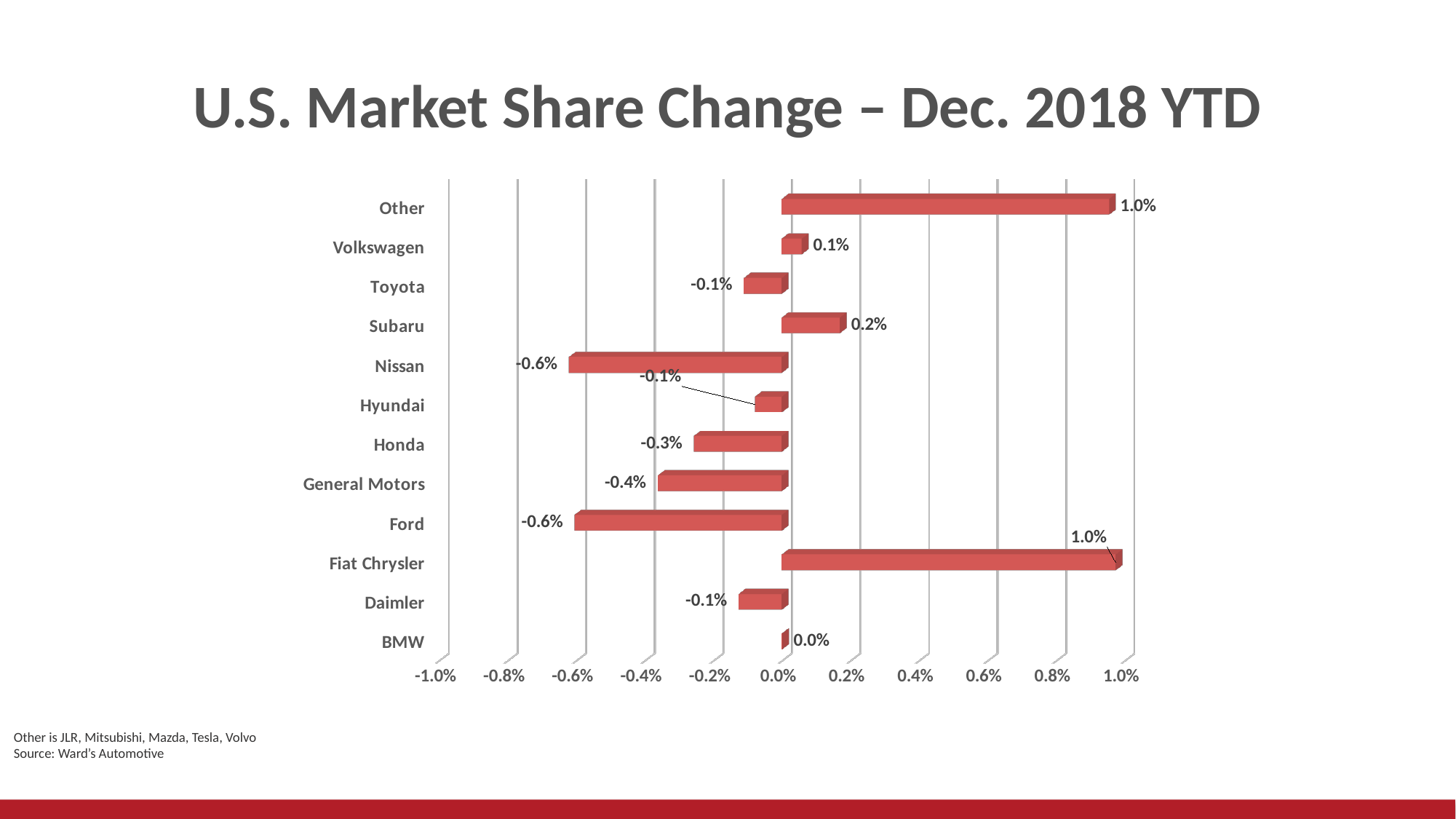
What is the market share change for General Motors? -0.4% What is the title of the chart? U.S. Market Share Change – Dec. 2018 YTD What is the market share change for BMW? 0.0% Which has the larger market share change, Honda or Ford? Honda How many manufacturers (categories) are shown in the chart? 12 What is the market share change for Honda? -0.3% Is the value for Fiat Chrysler greater or less than 0.8%? greater What kind of chart is shown on the slide? Bar chart Which has the larger market share change, Subaru or Volkswagen? Subaru What is the difference between the market share change for Subaru and for Honda? 0.5% What is the market share change for Subaru? 0.2% What is the market share change for Nissan? -0.6%